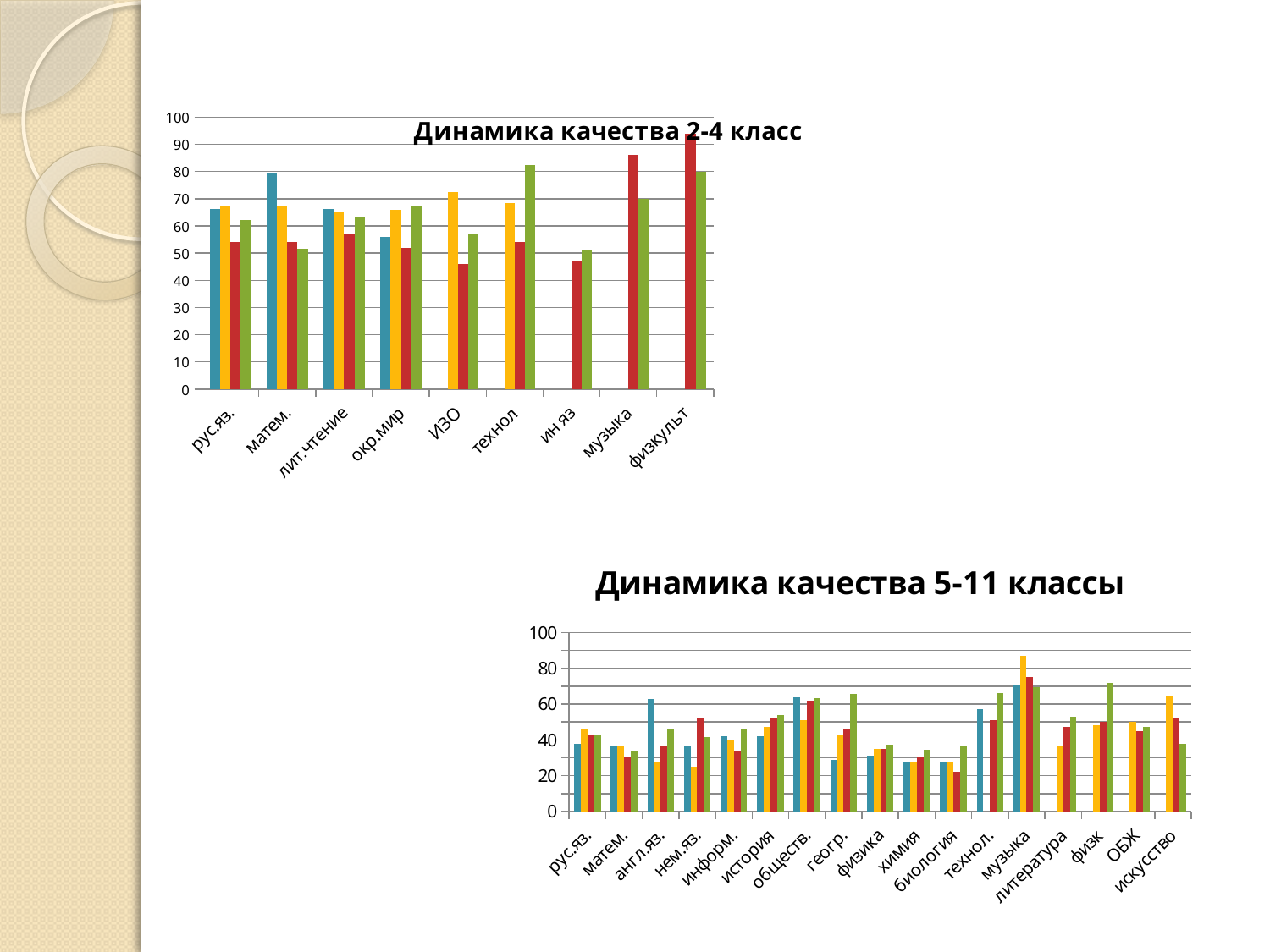
In the chart "Динамика качества 2-4 класс", is the value of the red bar for ИЗО greater or less than 50? less In the chart "Динамика качества 2-4 класс", which is larger: the blue bar for матем. or the blue bar for рус.яз.? матем. How many categories are shown on the x axis of the chart "Динамика качества 2-4 класс"? 9 In the chart "Динамика качества 5-11 классы", is the value of the yellow bar for музыка greater or less than 80? greater In the chart "Динамика качества 2-4 класс", which category contains the tallest bar? физкульт In the chart "Динамика качества 5-11 классы", which category contains the tallest bar? музыка In the chart "Динамика качества 2-4 класс", is the value of the blue bar for матем. greater or less than 70? greater How many categories are shown on the x axis of the chart "Динамика качества 5-11 классы"? 17 What kind of chart is "Динамика качества 2-4 класс"? bar chart What kind of chart is "Динамика качества 5-11 классы"? bar chart